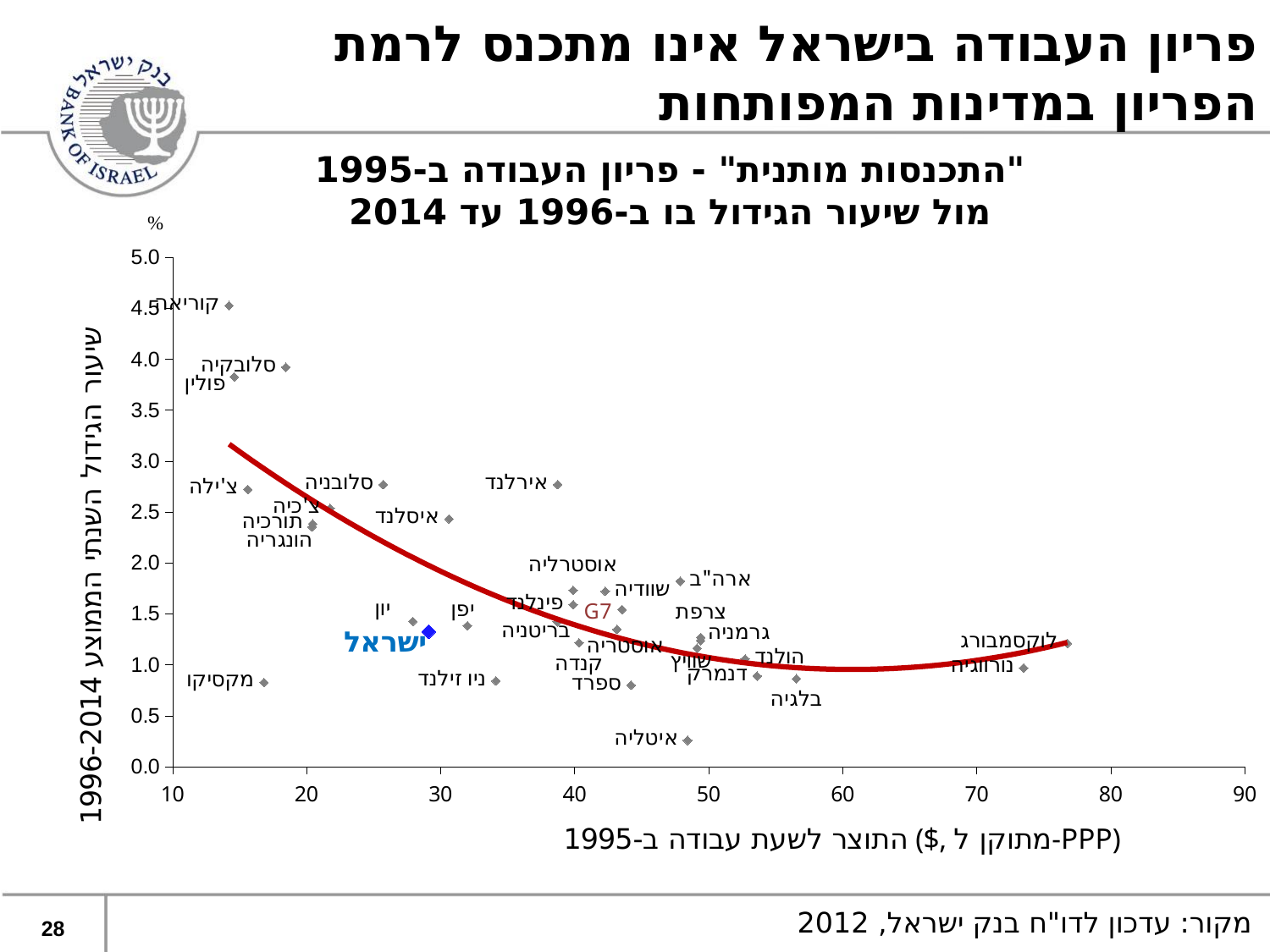
What kind of chart is shown on the slide? scatter chart As 1995 output per work hour increases along the x axis, do the growth rates generally rise or fall? fall Which country's point is highlighted in blue on the chart? Israel (ישראל) Which country had higher output per work hour in 1995, Luxembourg (לוקסמבורג) or Israel (ישראל)? Luxembourg (לוקסמבורג) Is the growth rate for Korea (קוריאה) greater or less than 4.0? greater Is the growth rate for Israel (ישראל) greater or less than 1.5? less Is the growth rate for Mexico (מקסיקו) greater or less than 1.0? less Which country has the lowest average annual growth rate (y axis) on the chart? Italy (איטליה) Which has a higher growth rate, Ireland (אירלנד) or Israel (ישראל)? Ireland (אירלנד) Which country has the highest average annual growth rate (y axis) on the chart? Korea (קוריאה)